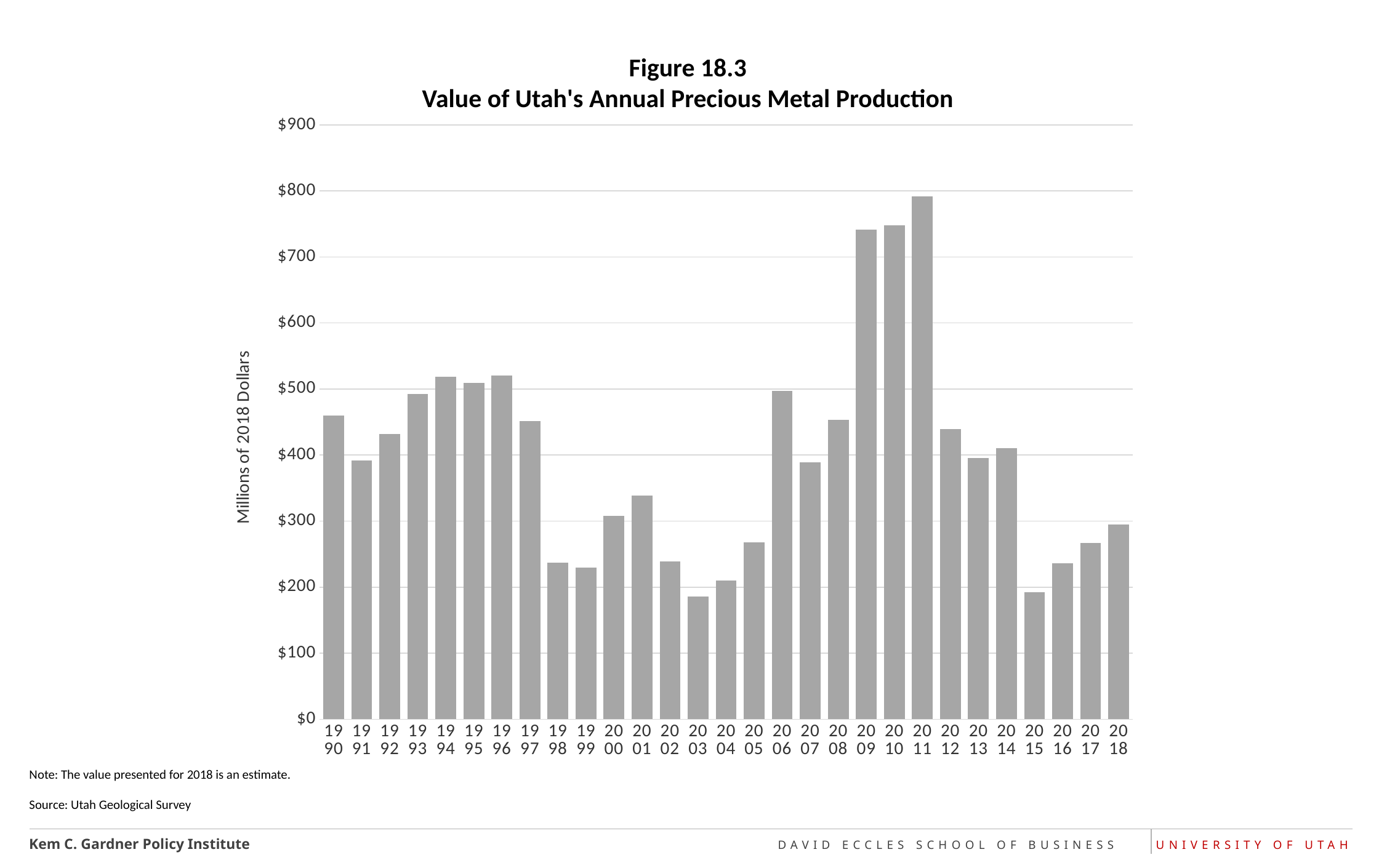
Is the value for 2001 greater or less than $300? greater Which year has a larger value, 1991 or 1994? 1994 Which year has the lowest value of precious metal production? 2003 Which year has a larger value, 2009 or 2011? 2011 What is the label on the vertical axis? Millions of 2018 Dollars Is the value for 2011 greater or less than $700? greater Do the values rise or fall from 2011 to 2015? fall What kind of chart is shown on the slide? Bar chart How many years are plotted on the x axis? 29 Which year has the highest value of precious metal production? 2011 Is the value for 1990 greater or less than $400? greater